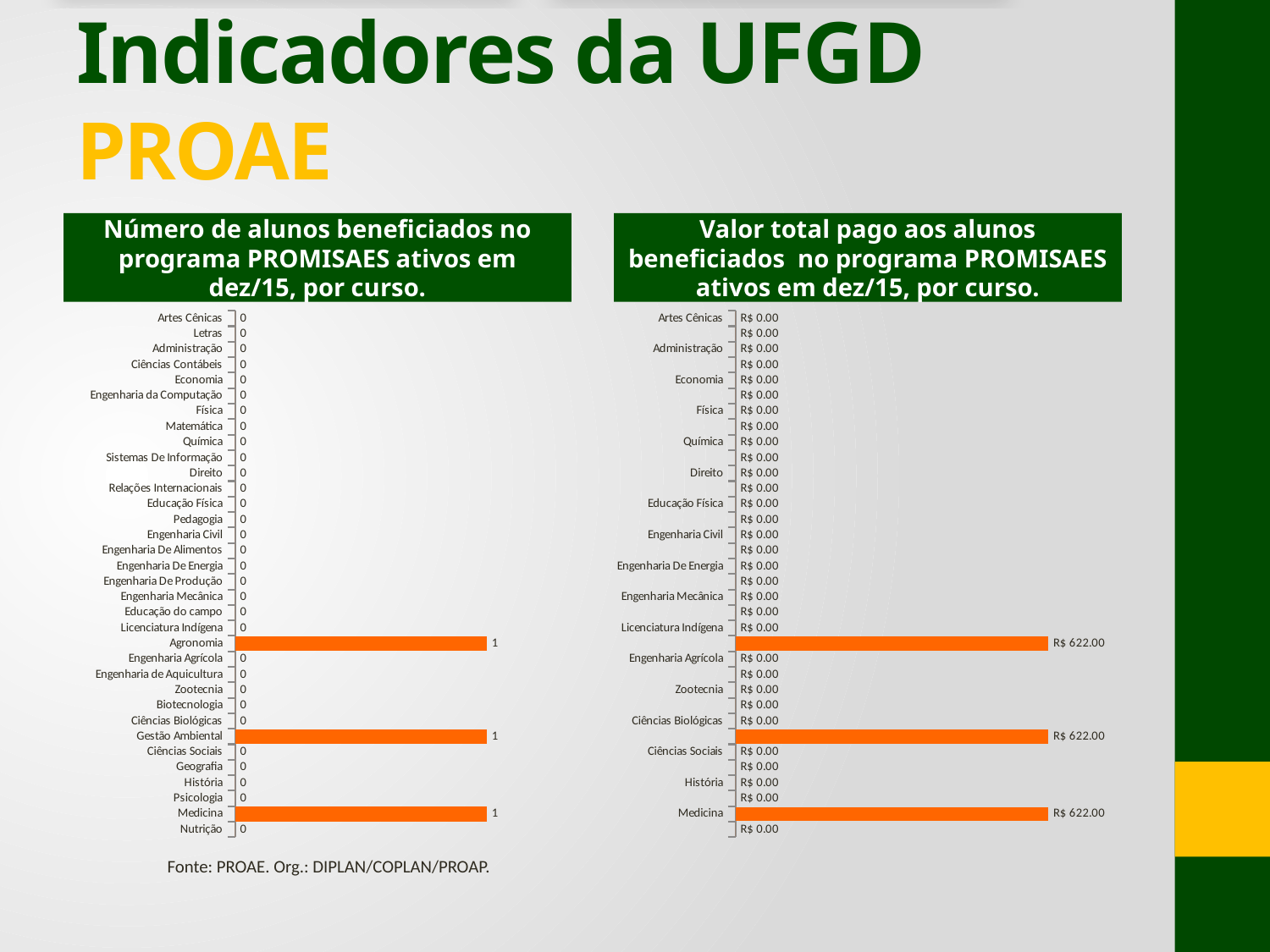
In the left chart (Número de alunos beneficiados), what is the difference between Medicina and Nutrição? 1 In the left chart (Número de alunos beneficiados), how many courses have a value of 1? 3 What kind of chart is the left chart, 'Número de alunos beneficiados no programa PROMISAES ativos em dez/15, por curso'? bar chart According to the note below the charts, what is the source (Fonte) of the data? PROAE In the right chart (Valor total pago aos alunos beneficiados), which is larger, Medicina or História? Medicina In the left chart (Número de alunos beneficiados), which is larger, Gestão Ambiental or Geografia? Gestão Ambiental In the left chart (Número de alunos beneficiados), what is the value for Agronomia? 1 In the right chart (Valor total pago aos alunos beneficiados), what is the value for Física? R$ 0.00 In the left chart (Número de alunos beneficiados), how many courses are listed on the axis? 34 In the right chart (Valor total pago aos alunos beneficiados), what is the value for Medicina? R$ 622.00 In the left chart (Número de alunos beneficiados), what is the value for Letras? 0 In the left chart (Número de alunos beneficiados), what is the value for Medicina? 1